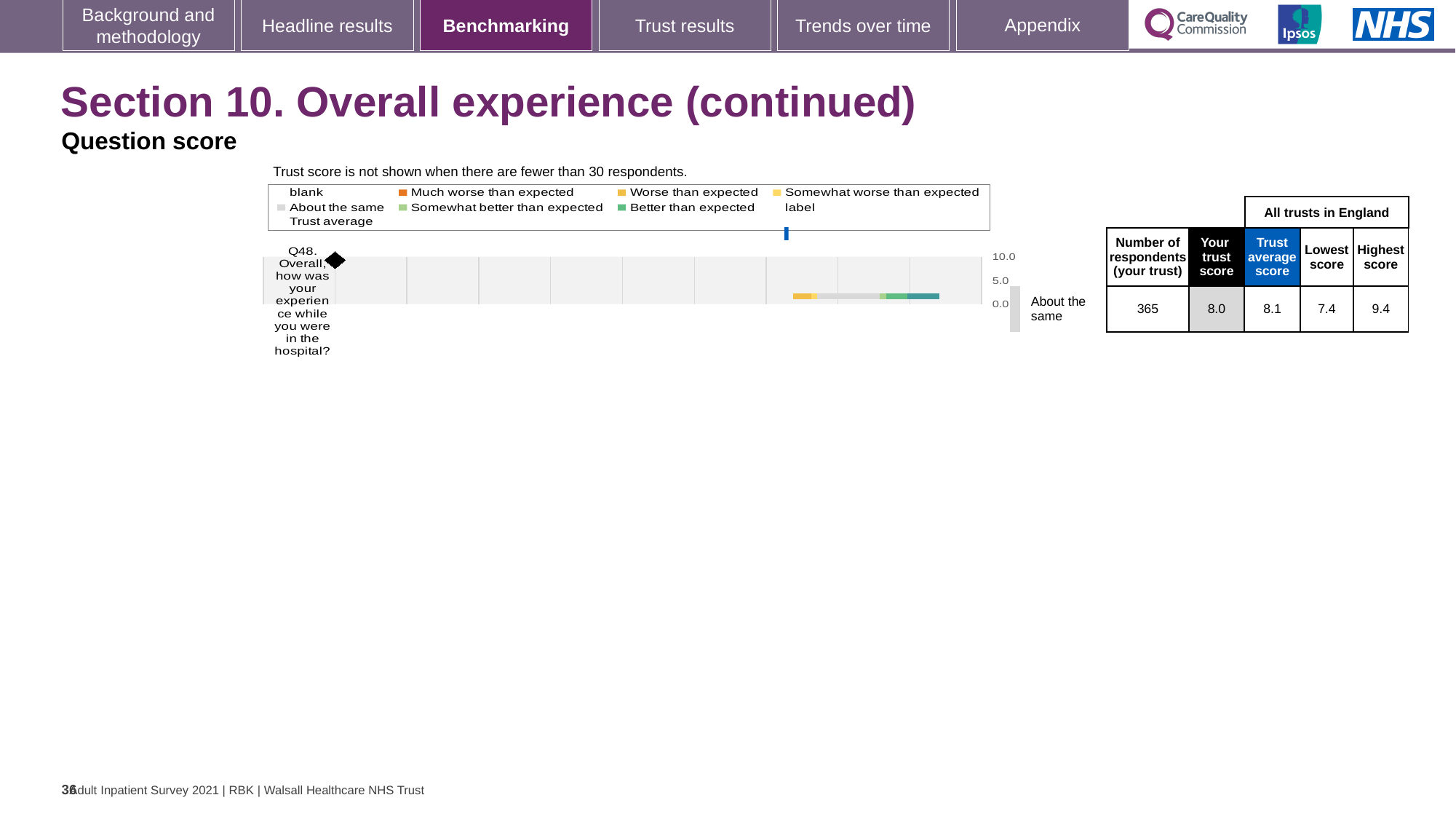
What kind of chart is used to show the Q48 benchmarking result? Bar chart What is the lowest score for Q48 among all trusts in England? 7.4 What benchmark category is shown next to the chart for Q48? About the same What is the 'Your trust score' value for Q48 in the table? 8.0 What is the difference between the highest score and the lowest score for Q48? 2.0 Is your trust score for Q48 greater or less than 5.0? greater By how much does the trust average score exceed your trust score for Q48? 0.1 How many questions are plotted on the chart? 1 Which is larger for Q48: your trust score or the trust average score? Trust average score How many respondents from your trust answered Q48? 365 What is the trust average score for Q48 across all trusts in England? 8.1 What is the highest score for Q48 among all trusts in England? 9.4